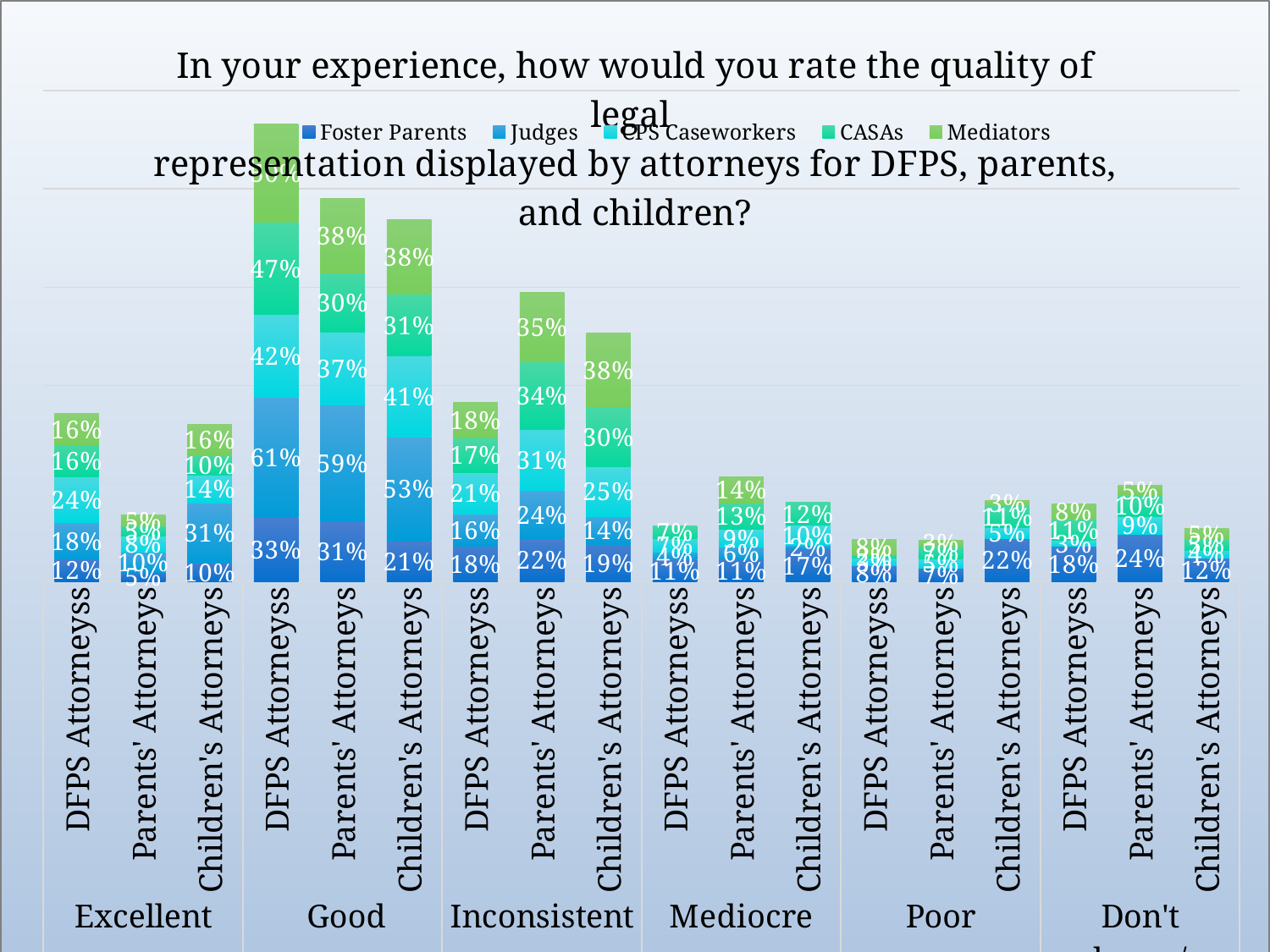
What percentage of CASAs rated Children's Attorneys as Inconsistent? 30% What percentage of Foster Parents rated DFPS Attorneys as Good? 33% What percentage of Mediators rated Parents' Attorneys as Inconsistent? 35% Which rating category has the tallest stacked bar for DFPS Attorneys? Good How many respondent groups does the legend list? 5 What percentage of Judges rated Children's Attorneys as Excellent? 31% How many rating categories are shown along the x axis? 6 What is the difference between the Judges value for DFPS Attorneys under Good and the Judges value for Children's Attorneys under Good? 8 percentage points What kind of chart is shown on the slide? Stacked bar chart What percentage of Judges rated DFPS Attorneys as Good? 61% Which is larger: the Judges value for DFPS Attorneys under Good or the Judges value for Parents' Attorneys under Good? DFPS Attorneys under Good What percentage of CPS Caseworkers rated Children's Attorneys as Good? 41%